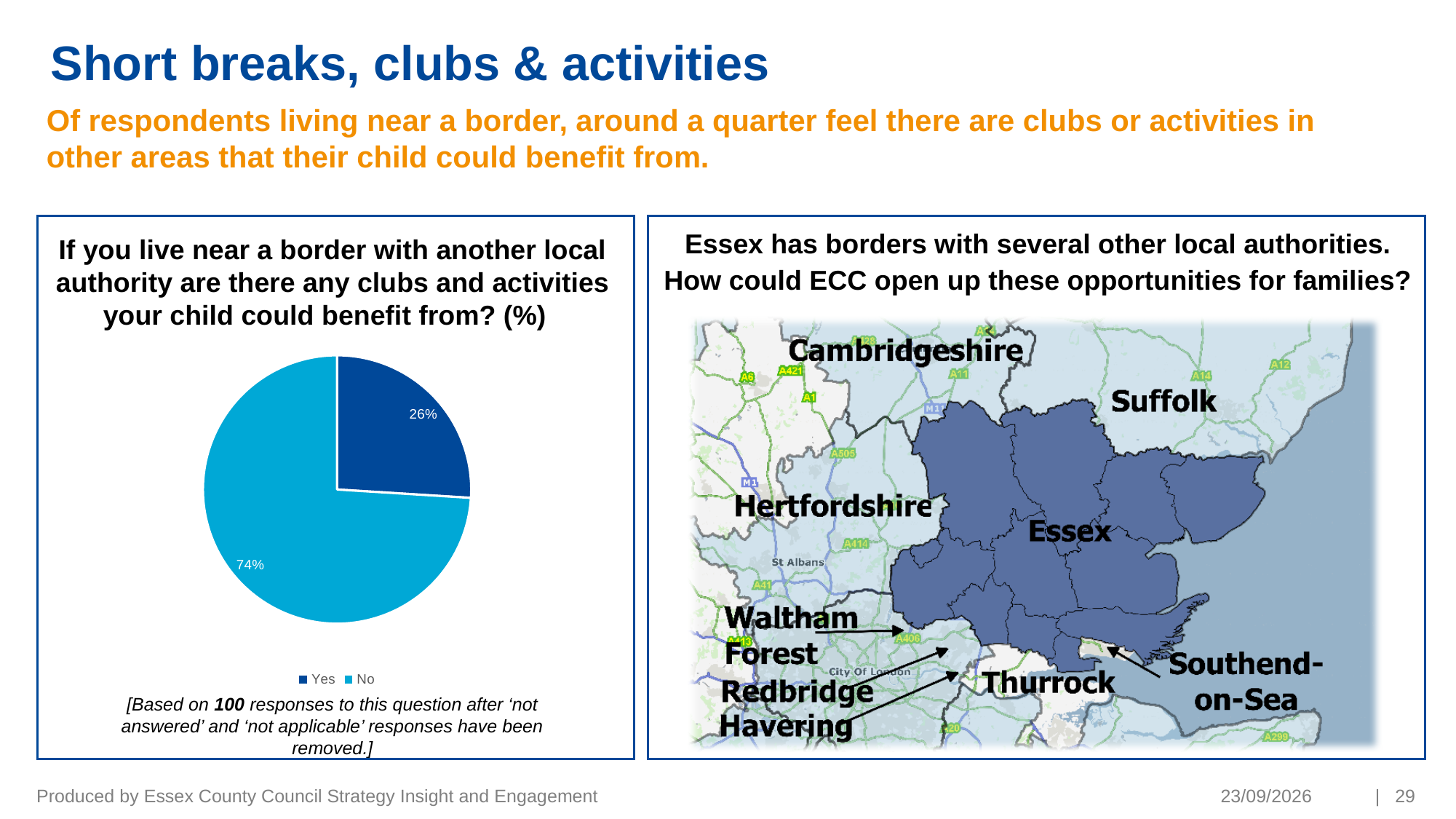
How many responses is the pie chart based on, according to the note below it? 100 Which is larger, the share for 'Yes' or the share for 'No'? No What percentage of respondents answered 'No'? 74% Which colour represents the 'No' response in the pie chart? light blue What percentage of respondents answered 'Yes'? 26% What share of the pie does the 'Yes' slice represent? 26% How many entries does the legend list? 2 How many slices does the pie chart have? 2 Which response has the largest share of the pie? No What is the difference in percentage points between the 'No' and 'Yes' responses? 48 Which response has the smallest share of the pie? Yes What kind of chart is shown on the slide? pie chart